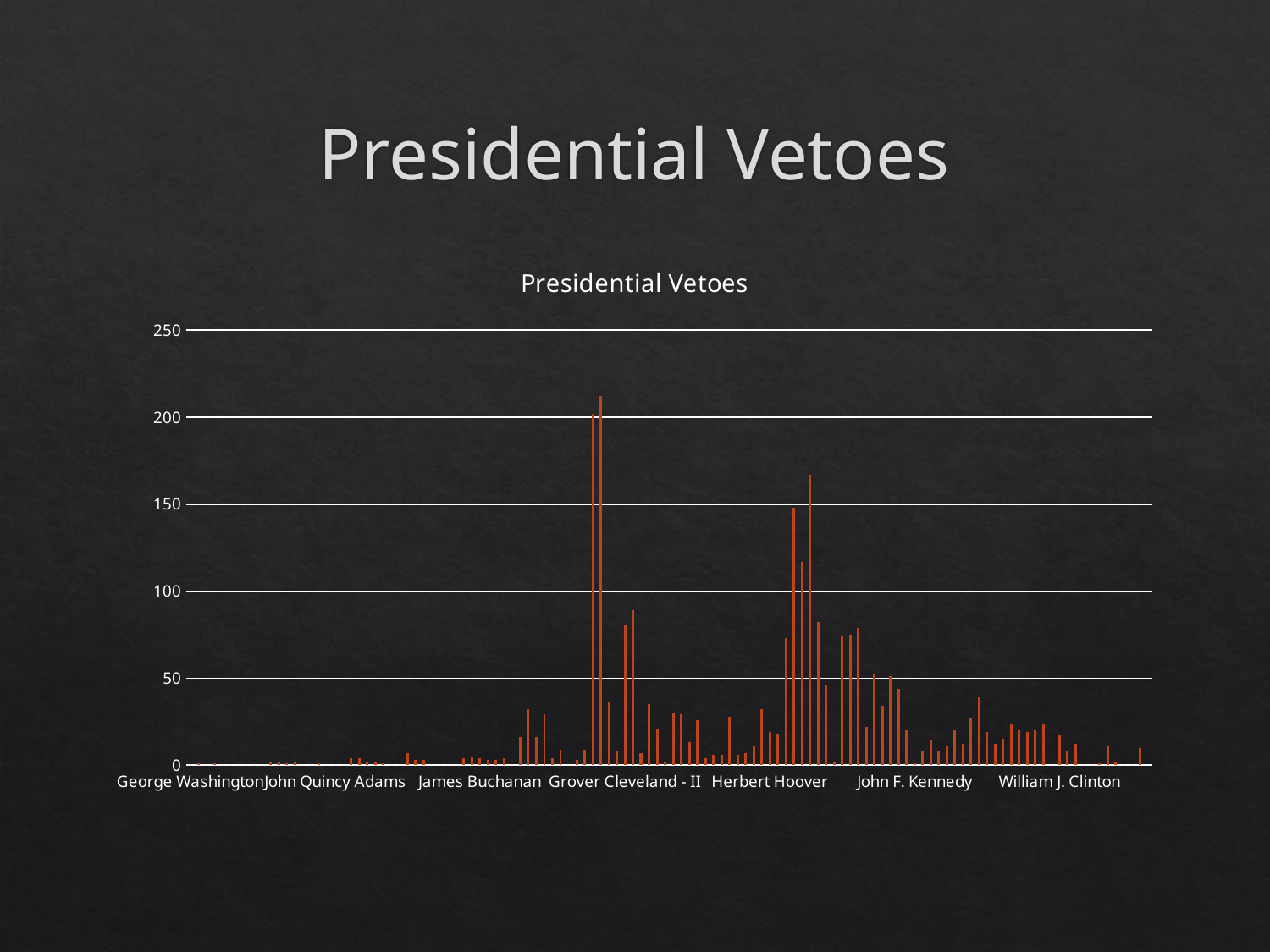
How many president names are printed as labels along the horizontal axis? 7 Is the tallest bar in the chart greater or less than 250? less Which president's name is the last label on the horizontal axis? William J. Clinton Is the second-tallest bar in the chart greater or less than 150? greater What is the title of the chart? Presidential Vetoes What is the highest value shown on the vertical axis of the chart? 250 What kind of chart is shown on the slide? bar chart Is the tallest bar in the chart greater or less than 200? greater